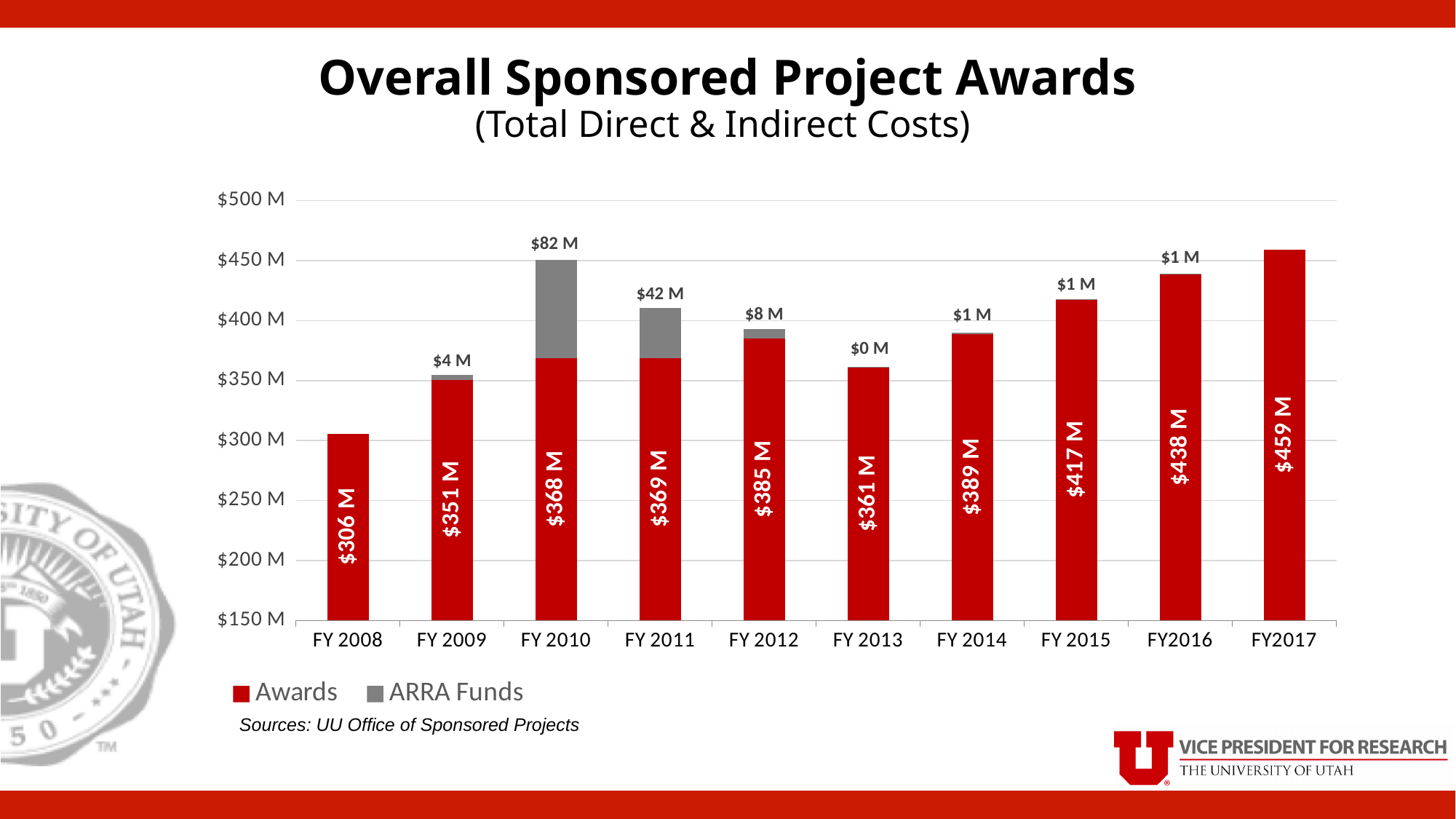
Which fiscal year has the lowest Awards value? FY 2008 What kind of chart is shown on the slide? Stacked bar chart Which has the larger Awards value, FY 2012 or FY 2013? FY 2012 How many series does the legend list? 2 What are the two series named in the legend? Awards and ARRA Funds What is the Awards value for FY 2008? $306 M What is the total of the stacked bar for FY 2010 (Awards plus ARRA Funds)? $450 M How many fiscal years are shown on the x axis? 10 What is the difference between the Awards value for FY2017 and for FY 2008? $153 M What is the ARRA Funds value for FY 2010? $82 M Which fiscal year has the largest ARRA Funds value? FY 2010 Which fiscal year has the highest Awards value? FY2017